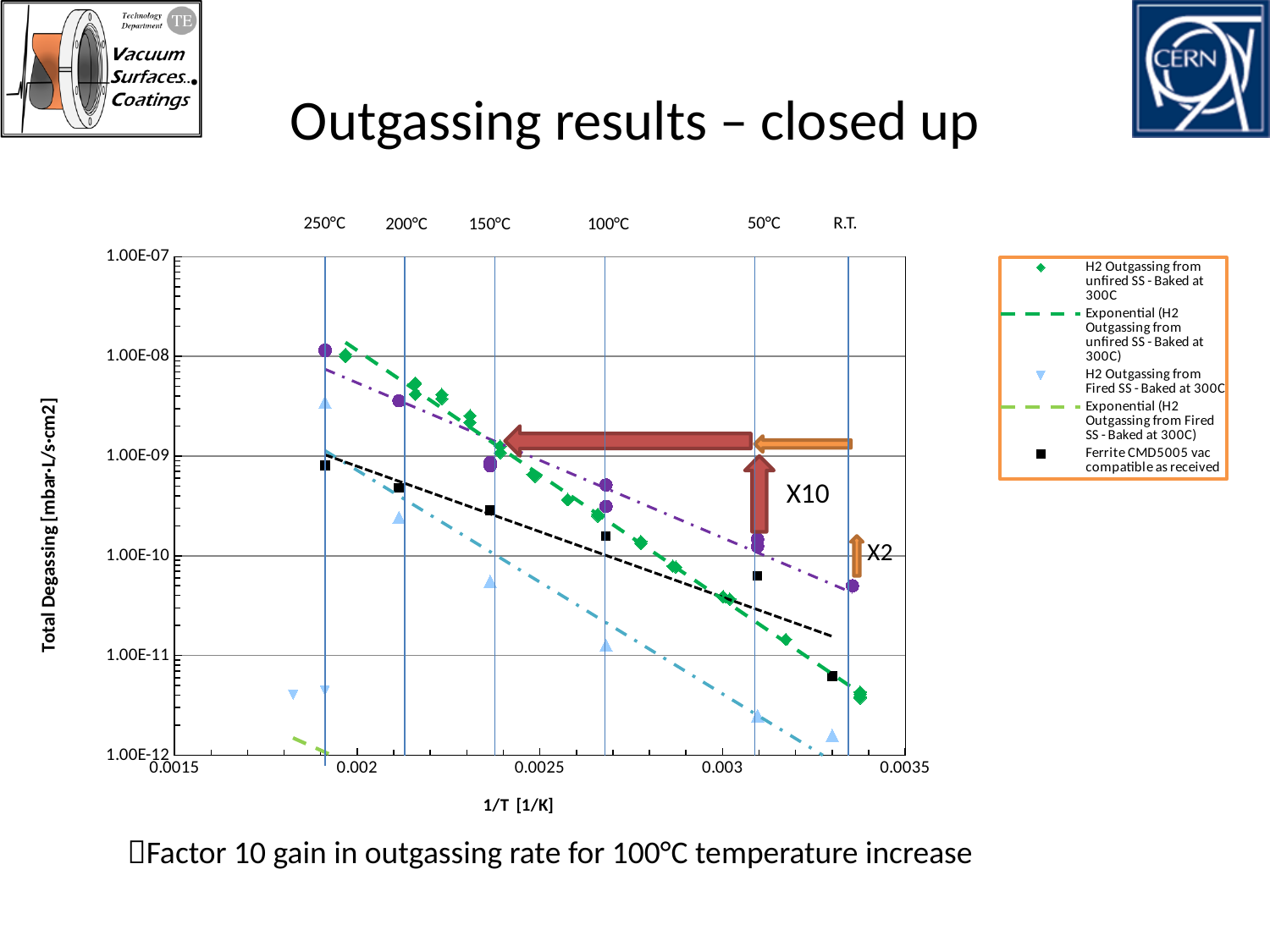
Is the value for Ferrite CMD5005 at 250°C (around 1/T = 0.0019) greater or less than 1.00E-09? less At 250°C, which series has the higher outgassing value: H2 Outgassing from unfired SS or H2 Outgassing from Fired SS? H2 Outgassing from unfired SS What is the title of the chart's y axis? Total Degassing [mbar·L/s·cm2] Do the outgassing values rise or fall as 1/T increases along the x axis? fall What kind of chart is shown on the slide? scatter chart At 250°C, which series has the higher outgassing value: H2 Outgassing from unfired SS or Ferrite CMD5005? H2 Outgassing from unfired SS What is the title of the chart's x axis? 1/T [1/K] Is the value for H2 Outgassing from Fired SS at 50°C (around 1/T = 0.0031) greater or less than 1.00E-11? less Is the value for H2 Outgassing from unfired SS at R.T. (around 1/T = 0.0034) greater or less than 1.00E-11? less How many series does the chart legend list? 5 How many temperature labels are shown along the top of the chart? 6